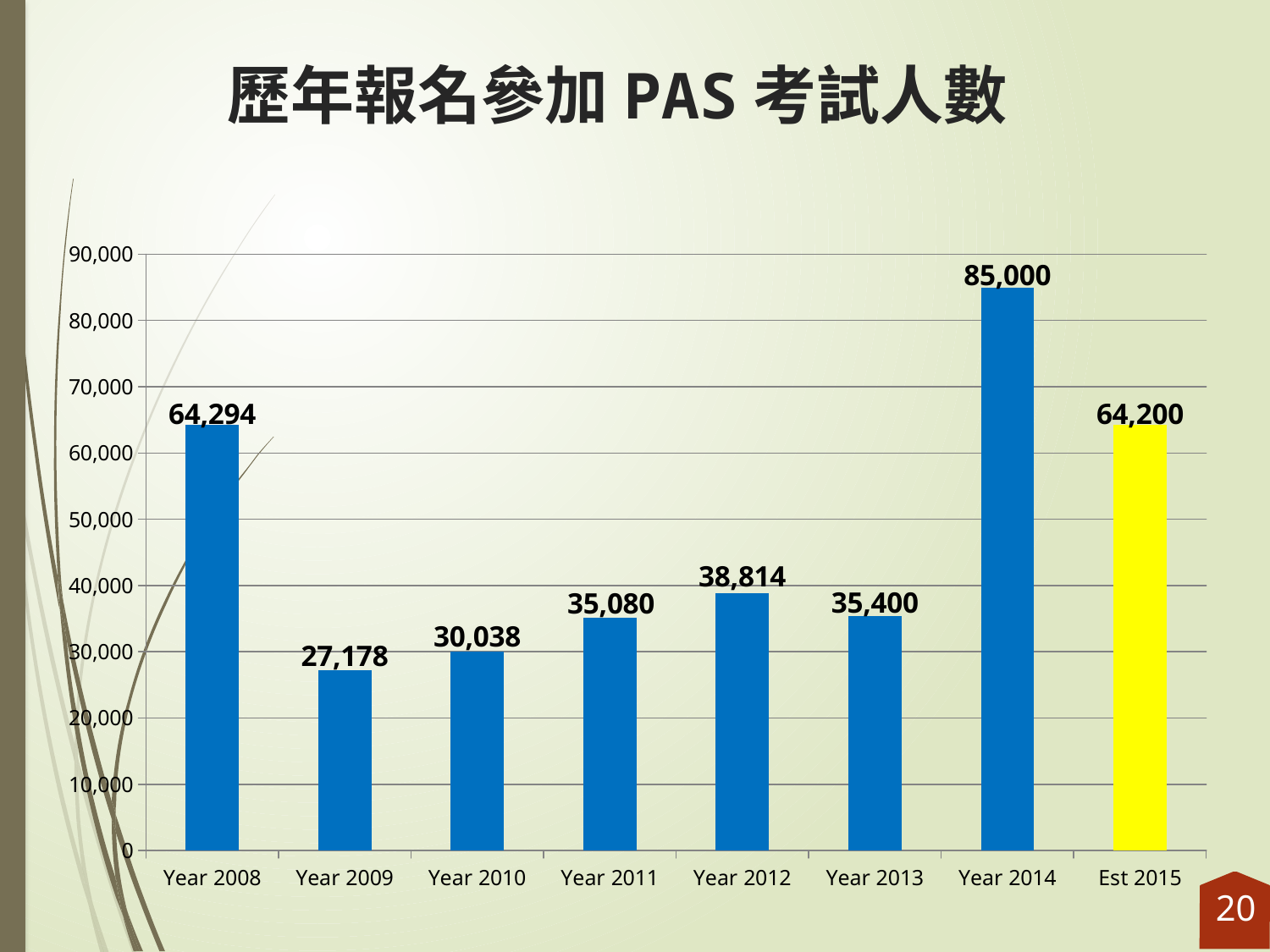
Which bar is coloured yellow instead of blue? Est 2015 Which is larger, the value for Year 2011 or the value for Year 2013? Year 2013 Is the value for Year 2010 greater or less than 40,000? less What is the value for Year 2008? 64,294 What is the value for Est 2015? 64,200 What is the value for Year 2012? 38,814 What kind of chart is shown on the slide? bar chart What is the difference between the values for Year 2014 and Year 2013? 49,600 Which category has the highest value? Year 2014 How many categories are shown on the x axis? 8 Which category has the lowest value? Year 2009 Do the values rise or fall from Year 2009 to Year 2012? rise